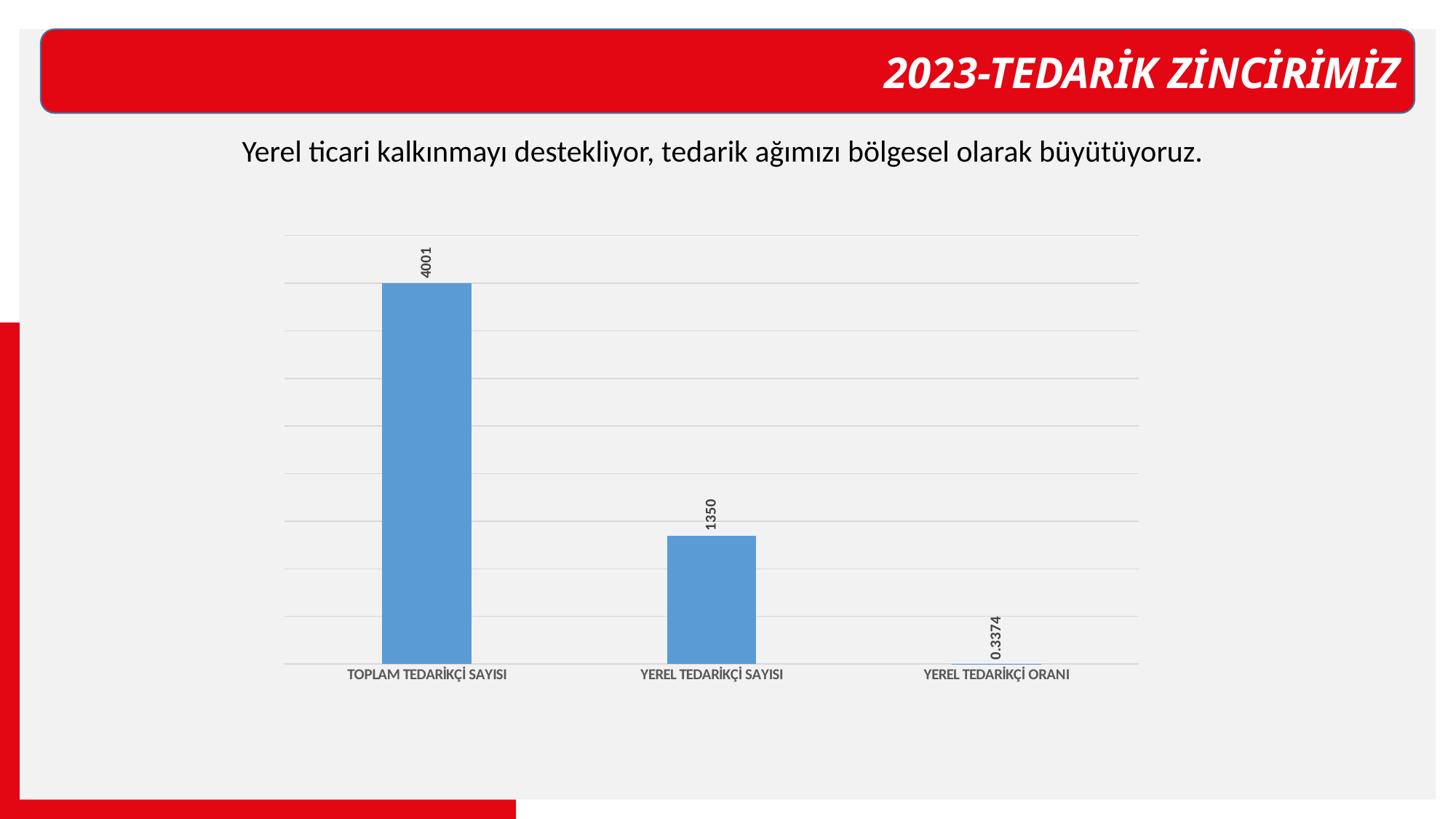
What kind of chart is shown on the slide? Bar chart What is the difference between the values for TOPLAM TEDARİKÇİ SAYISI and YEREL TEDARİKÇİ SAYISI? 2651 Do the values rise or fall from left to right along the x axis? Fall Which category has the lowest value? YEREL TEDARİKÇİ ORANI What is the value for TOPLAM TEDARİKÇİ SAYISI? 4001 How many categories are shown on the x axis of the chart? 3 What colour are the bars in the chart? Blue What is the value for YEREL TEDARİKÇİ SAYISI? 1350 What is the value for YEREL TEDARİKÇİ ORANI? 0.3374 Which category has the highest value? TOPLAM TEDARİKÇİ SAYISI Which is larger, the value for YEREL TEDARİKÇİ SAYISI or the value for YEREL TEDARİKÇİ ORANI? YEREL TEDARİKÇİ SAYISI What is the title shown in the red banner at the top of the slide? 2023-TEDARİK ZİNCİRİMİZ